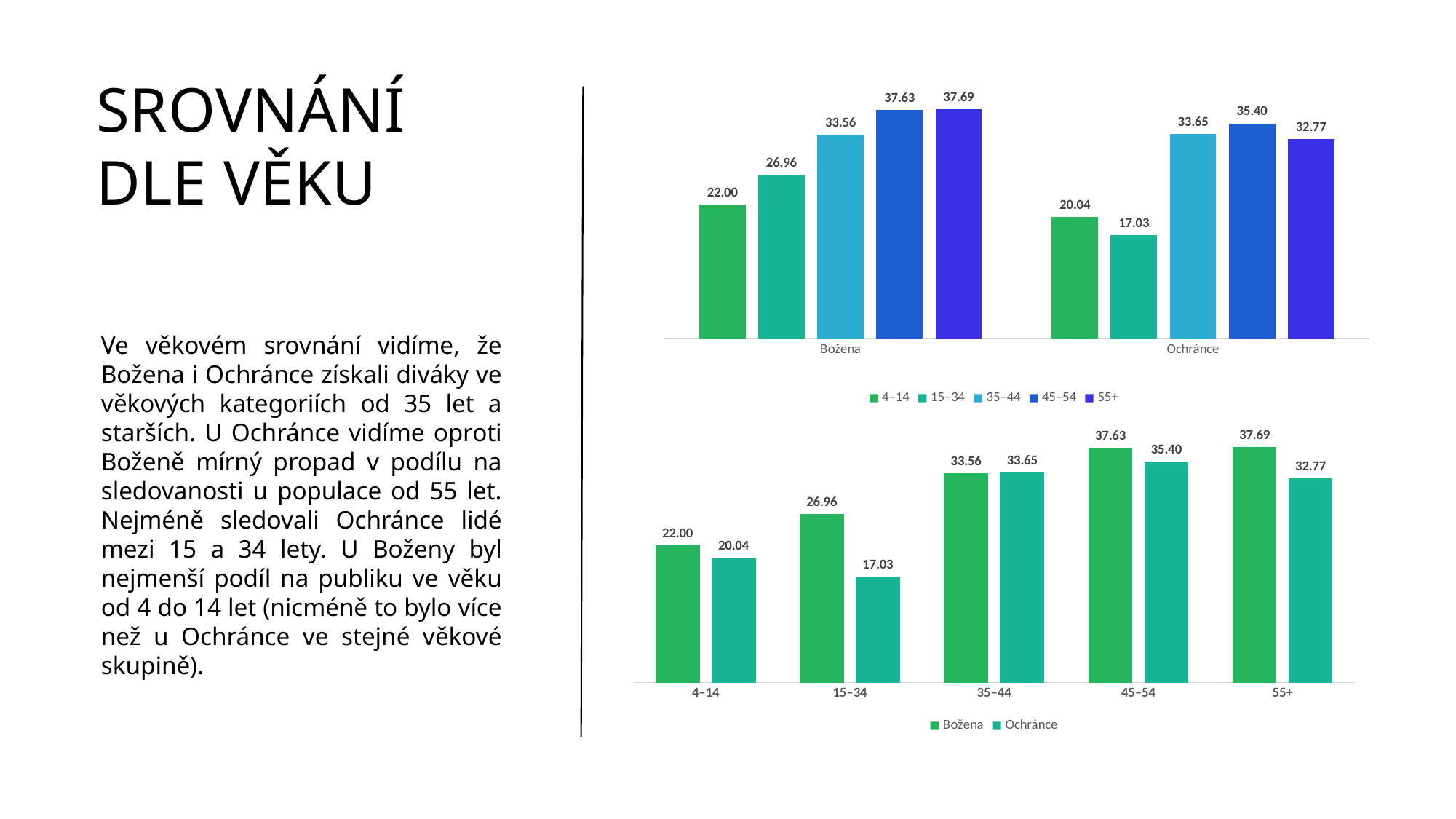
In the bottom chart, what is the difference between Božena and Ochránce in the 55+ category? 4.92 In the bottom chart, what is the difference between Božena and Ochránce in the 15–34 category? 9.93 In the top chart, what is the value for the 55+ series in the Ochránce group? 32.77 In the bottom chart, what is the value for Ochránce in the 35–44 category? 33.65 In the bottom chart, which age category has the lowest value for Božena? 4–14 In the top chart, what is the value for the 15–34 series in the Božena group? 26.96 What kind of chart is the bottom chart? Bar chart In the bottom chart, which age category has the lowest value for Ochránce? 15–34 How many series does the legend of the top chart list? 5 In the bottom chart, which is larger in the 35–44 category, Božena or Ochránce? Ochránce In the top chart, which age series has the highest value in the Ochránce group? 45–54 How many age categories are shown on the x axis of the bottom chart? 5